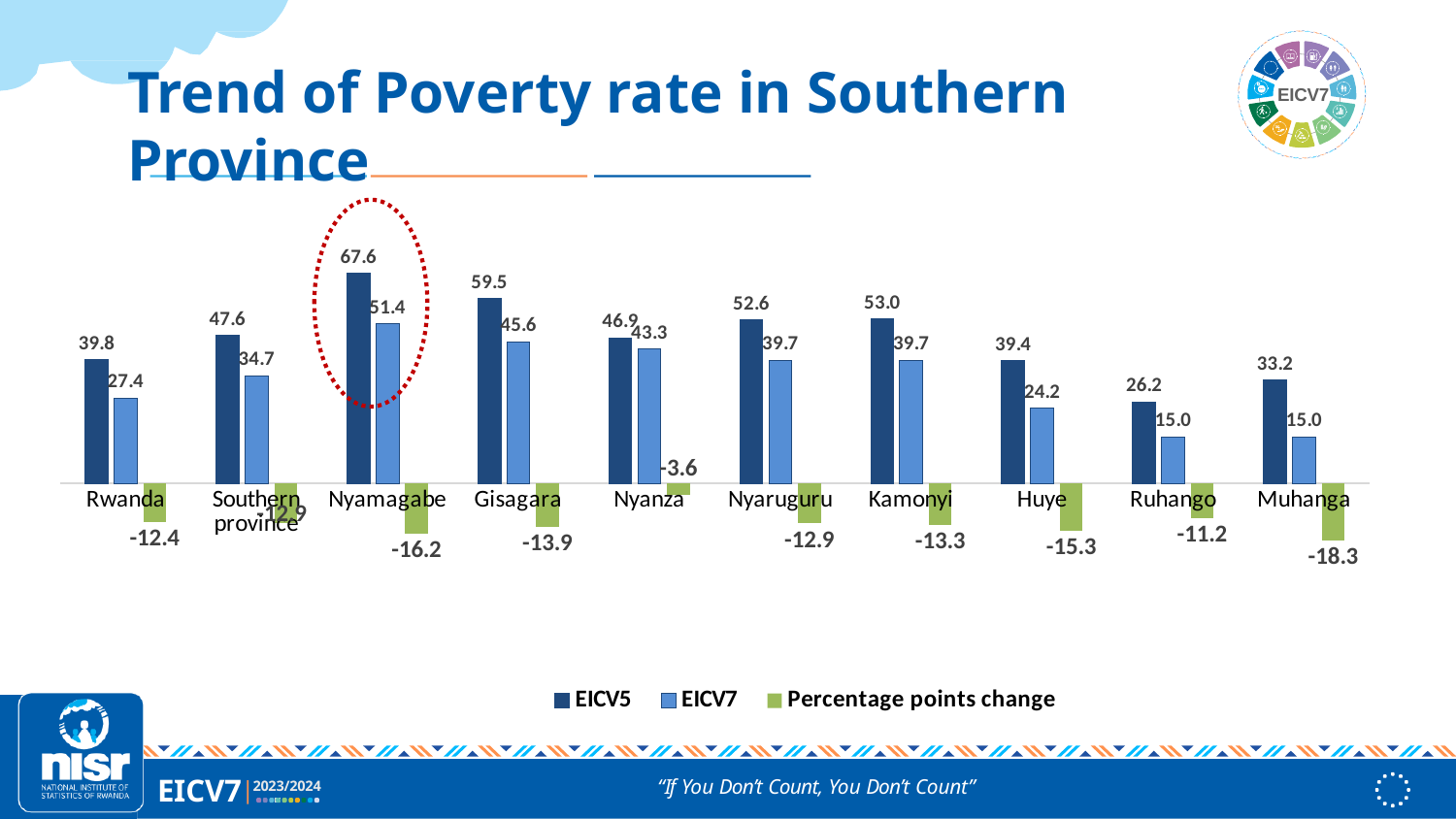
What is the difference between the EICV5 and EICV7 poverty rates for Huye? 15.2 What is the EICV5 poverty rate for Nyamagabe? 67.6 Which category has the smallest percentage points change in absolute terms? Nyanza Which category has the lowest EICV5 poverty rate? Ruhango What is the EICV7 poverty rate for Gisagara? 45.6 How many series does the legend list? 3 Which category has the highest EICV5 poverty rate? Nyamagabe What is the percentage points change shown for Muhanga? -18.3 What kind of chart is shown on the slide? Bar chart What is the EICV7 poverty rate for Rwanda? 27.4 How many categories are shown on the x axis? 10 Which is larger, the EICV7 poverty rate for Nyanza or for Nyaruguru? Nyanza